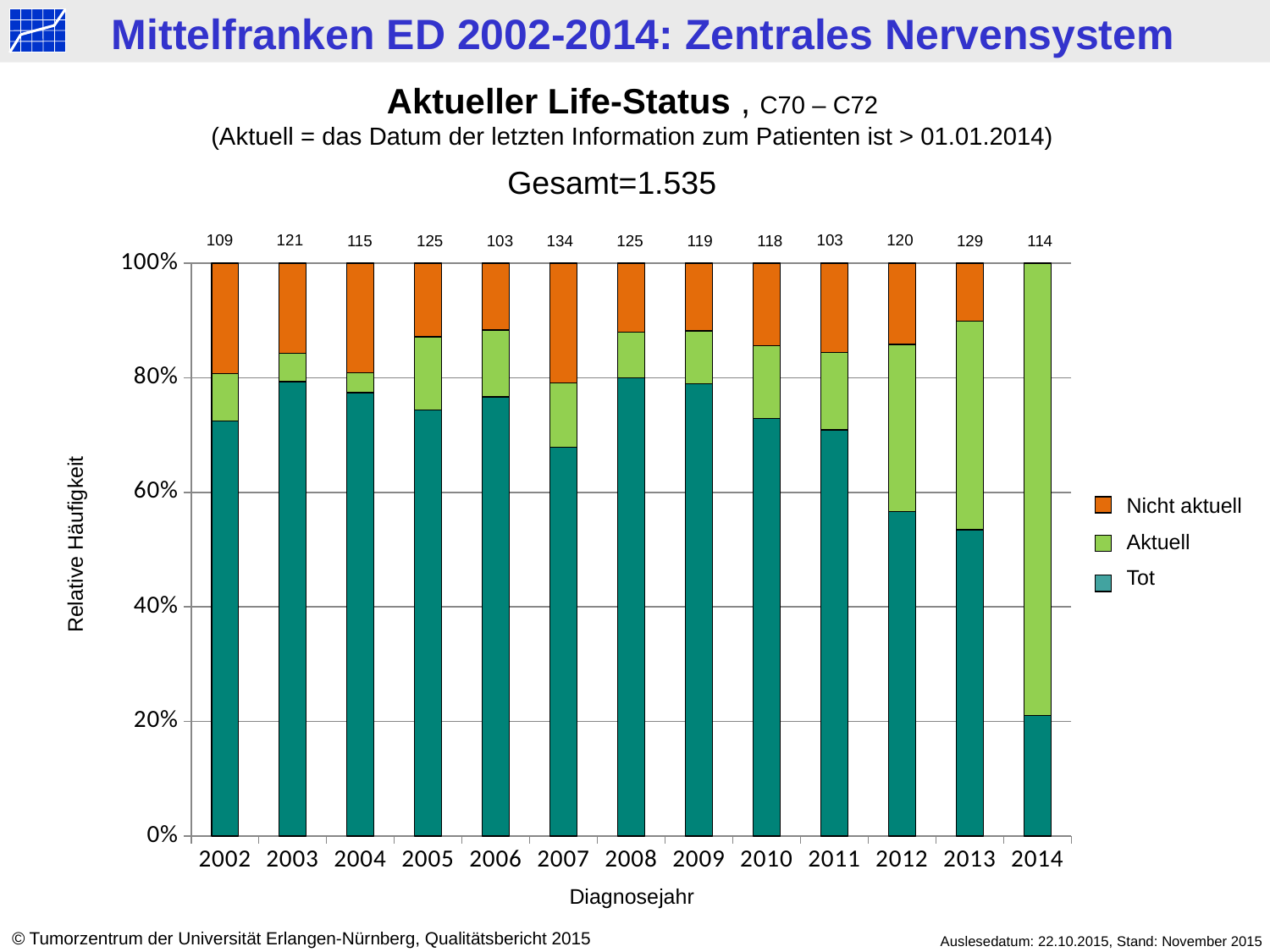
Is the 'Tot' share for 2014 greater or less than 40%? less What is the title of the x axis? Diagnosejahr What kind of chart is shown on the slide? Stacked bar chart How many diagnosis years are shown on the x axis? 13 How many series does the legend list? 3 What is the number printed above the bar for 2002? 109 Which diagnosis year has the highest number printed above its bar? 2007 Which has the larger number printed above its bar, 2005 or 2004? 2005 What is the difference between the numbers printed above the bars for 2003 and 2002? 12 What is the number printed above the bar for 2014? 114 What is the number printed above the bar for 2007? 134 Is the 'Tot' share for 2002 greater or less than 60%? greater